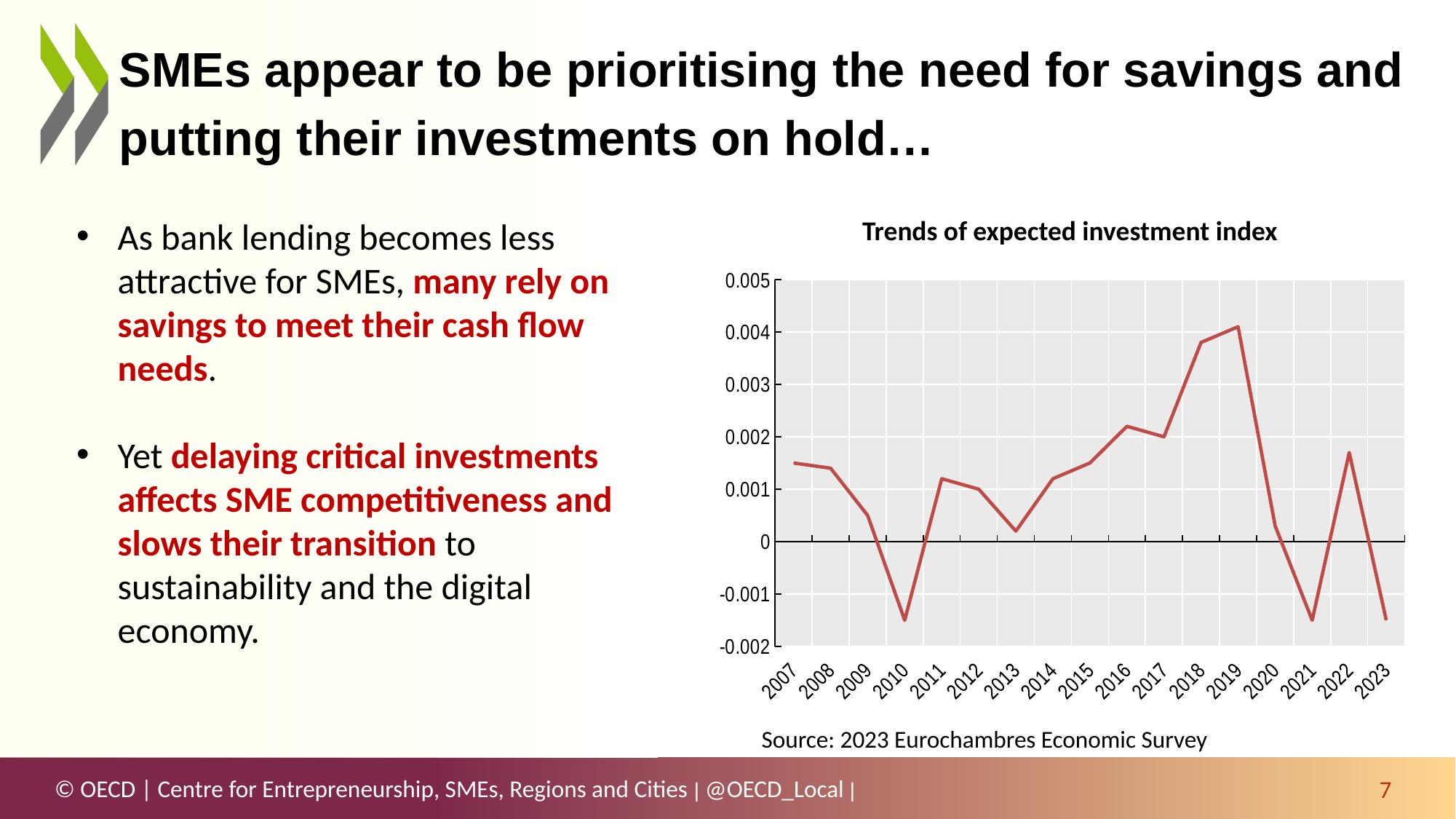
Is the value for 2010 greater or less than -0.001? less Does the expected investment index rise or fall between 2019 and 2021? Fall Is the value for 2013 greater or less than 0.001? less Which year has the larger value, 2018 or 2022? 2018 What source is cited below the chart? 2023 Eurochambres Economic Survey Is the value for 2019 greater or less than 0.003? greater Which year has the larger value, 2010 or 2013? 2013 What kind of chart is shown on the slide? Line chart In which year does the expected investment index reach its highest value? 2019 How many years are plotted on the x axis of the chart? 17 What is the title of the chart? Trends of expected investment index